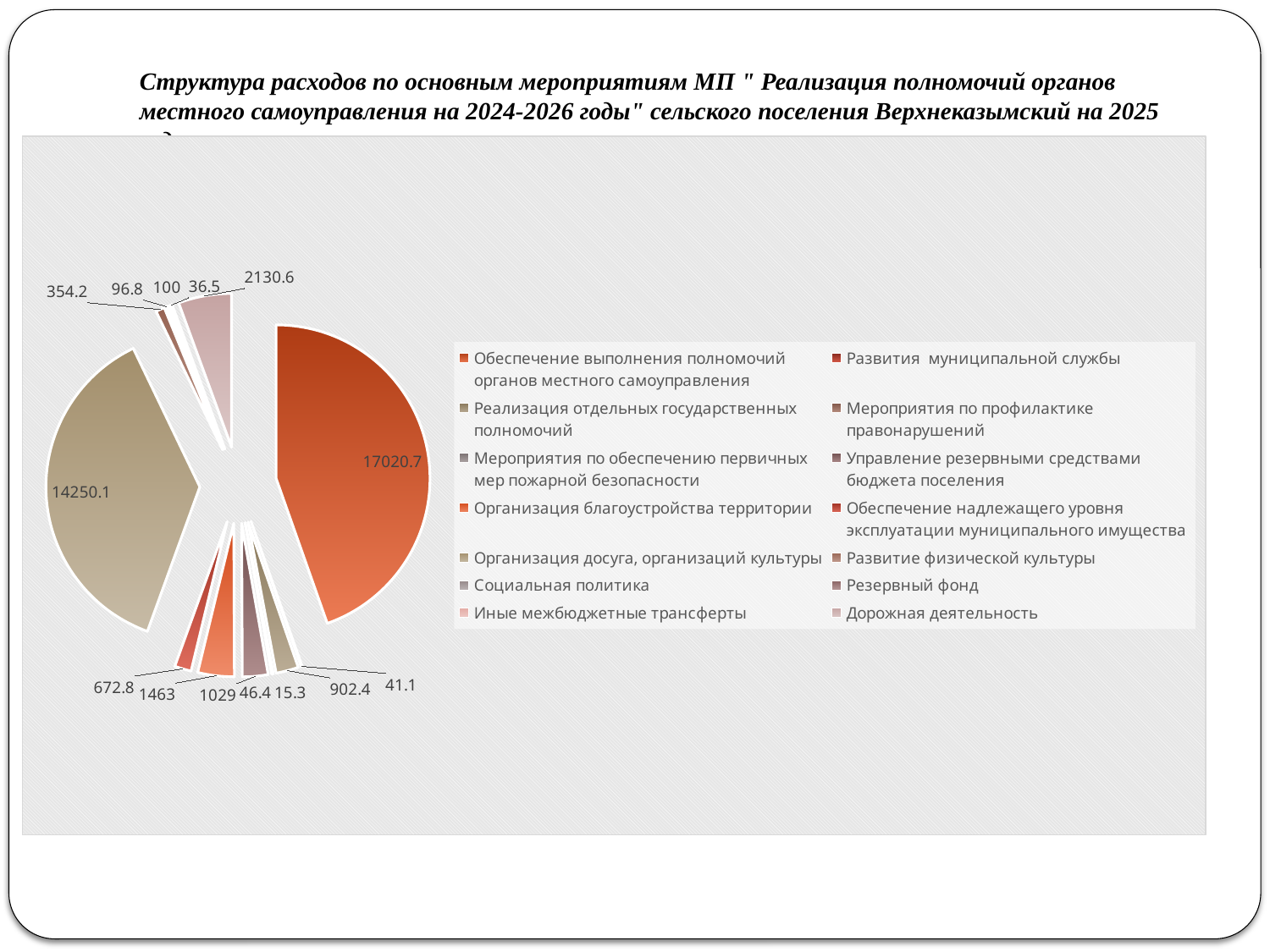
What is the difference between the two largest slices, 17020.7 and 14250.1? 2770.6 What is the smallest value labelled on the pie chart? 15.3 How many slices does the pie chart have? 14 What is the value for 'Реализация отдельных государственных полномочий'? 902.4 What is the value for 'Дорожная деятельность'? 2130.6 Which is larger, the slice labelled 1463 or the slice labelled 1029? 1463 What kind of chart is shown on the slide? pie chart What is the difference between the slice labelled 2130.6 and the slice labelled 1463? 667.6 How many entries does the legend list? 14 Which year does the chart title say the expenditure structure is for? 2025 Which slice has the largest value in the pie chart? 17020.7 (Обеспечение выполнения полномочий органов местного самоуправления) What is the value for 'Обеспечение выполнения полномочий органов местного самоуправления'? 17020.7